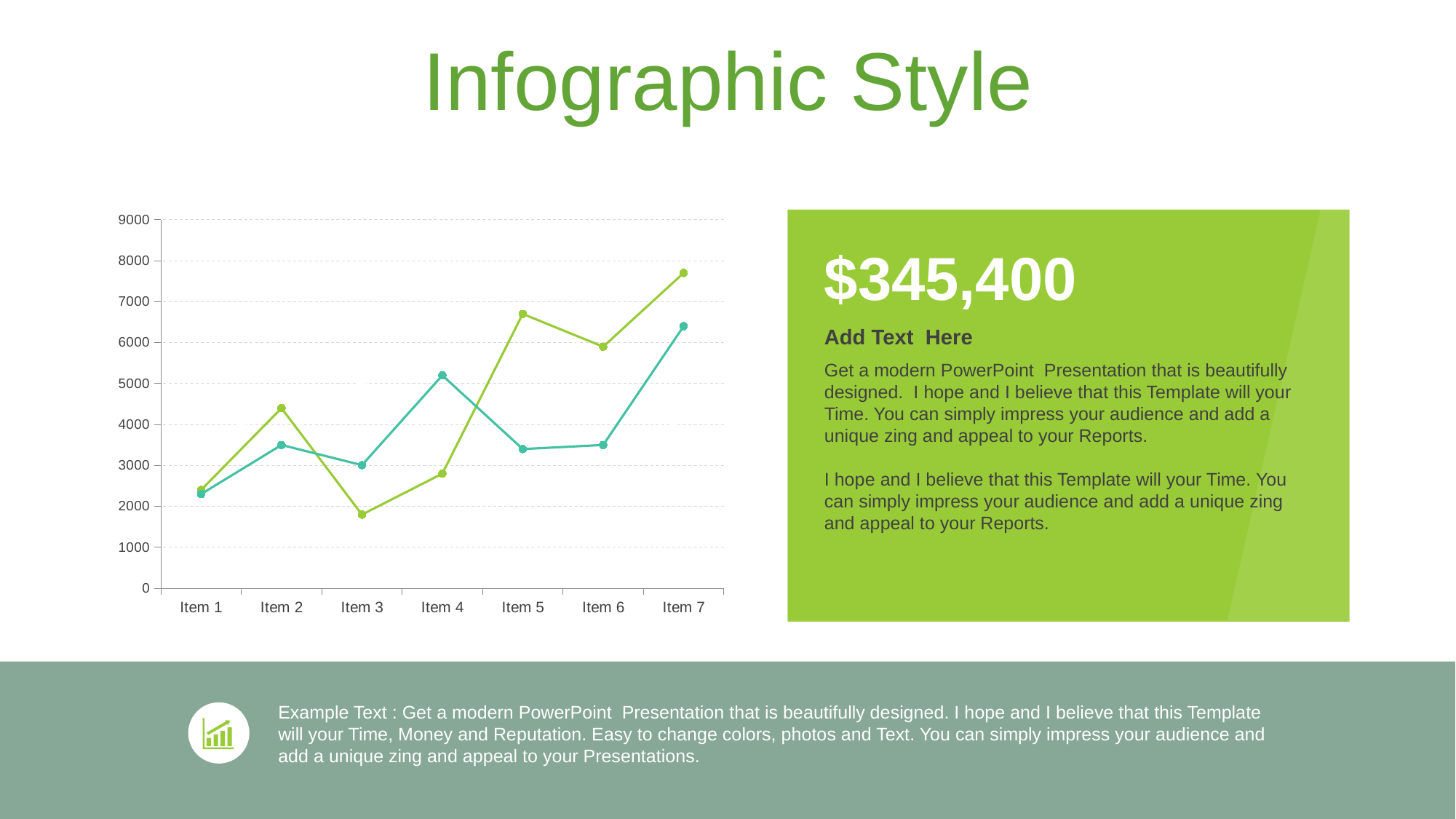
Is the value of the light green line at Item 3 greater or less than 2000? less Is the value of the teal line at Item 4 greater or less than 4000? greater Is the value of the teal line at Item 7 greater or less than 6000? greater At which item does the light green line reach its highest value? Item 7 What kind of chart is shown on the slide? line chart Does the light green line rise or fall from Item 5 to Item 6? fall At Item 5, which line has the higher value, the light green line or the teal line? the light green line At which item does the teal line reach its lowest value? Item 1 How many lines are plotted on the chart? 2 How many items are shown along the x axis of the chart? 7 At which item does the light green line reach its lowest value? Item 3